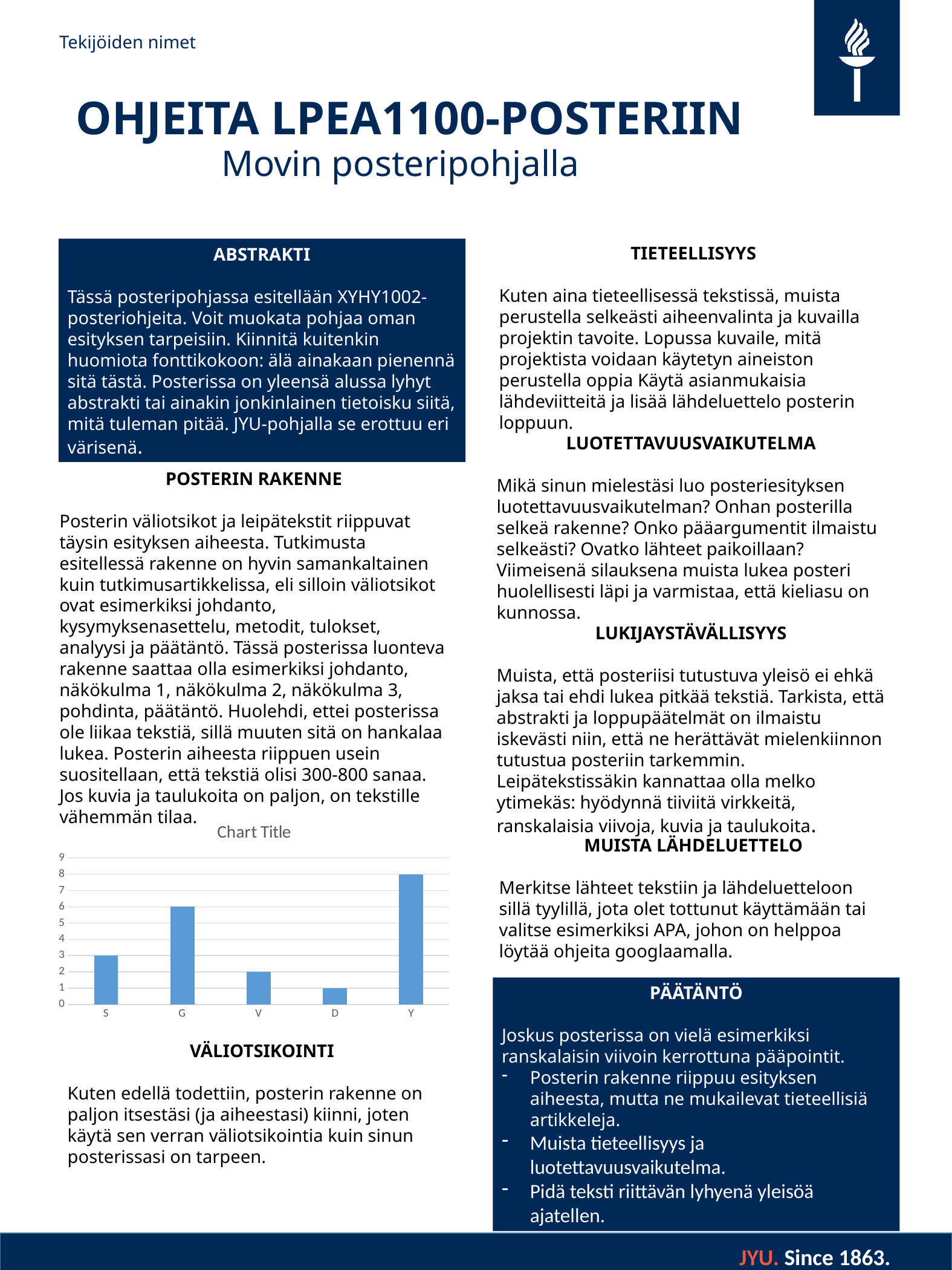
Which is larger in the chart, the value for S or the value for V? S What is the value for category S in the chart? 3 Which category has the highest value in the chart? Y What is the value for category D in the chart? 1 How many categories are shown on the x axis of the chart? 5 Which category has the lowest value in the chart? D What kind of chart is shown on the slide? bar chart What is the title of the chart? Chart Title What is the value for category G in the chart? 6 What is the value for category Y in the chart? 8 Is the value for V in the chart greater or less than 5? less What is the difference between the values for Y and G in the chart? 2